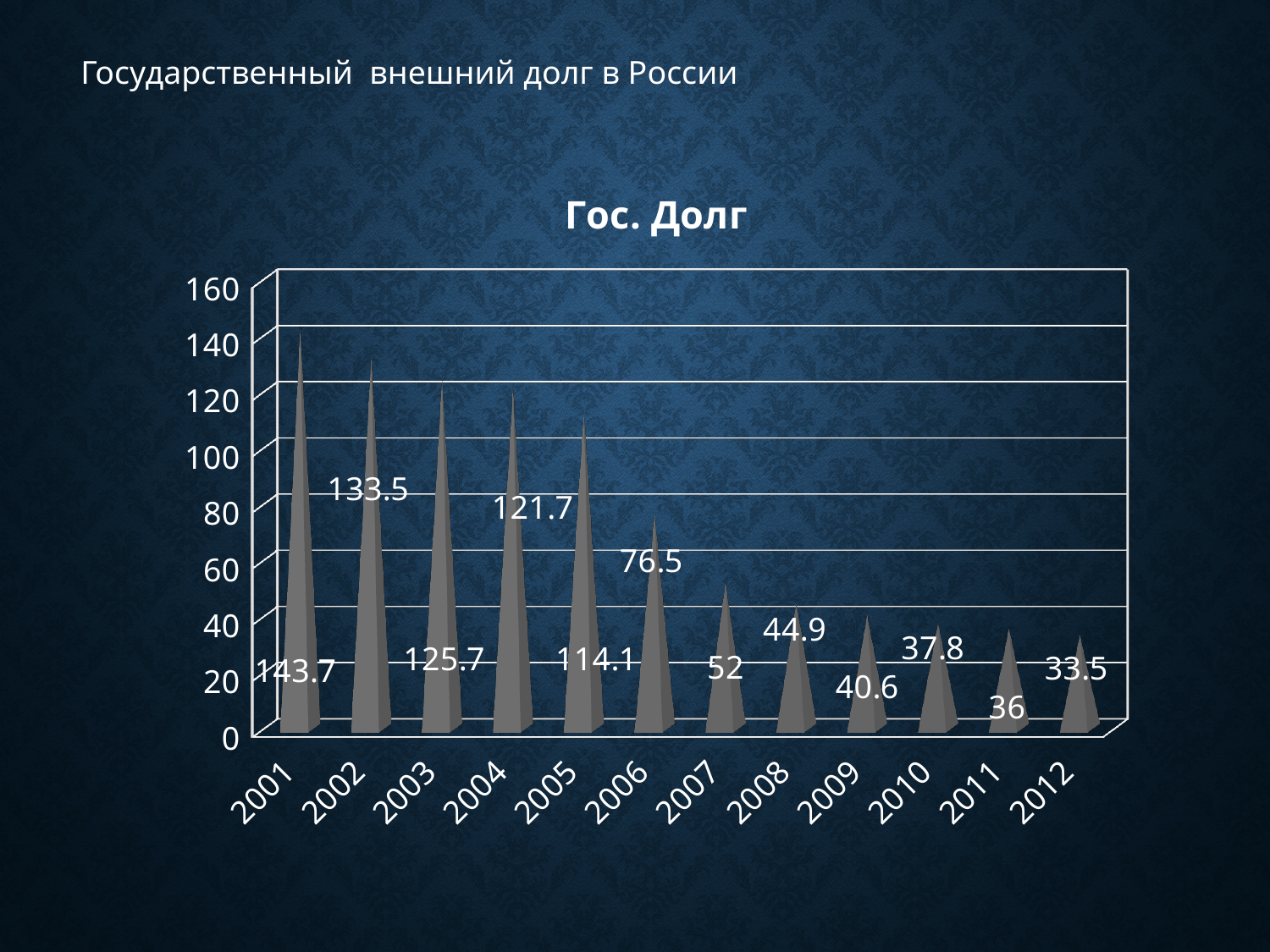
What is the value for 2006 in the Гос. Долг chart? 76.5 What is the value for 2001 in the Гос. Долг chart? 143.7 Which year has the highest value in the Гос. Долг chart? 2001 Which is larger in the Гос. Долг chart, the value for 2007 or the value for 2008? 2007 What kind of chart is the Гос. Долг chart? bar chart Do the values in the Гос. Долг chart rise or fall from 2001 to 2012? fall What is the difference between the values for 2001 and 2002 in the Гос. Долг chart? 10.2 Which year has the lowest value in the Гос. Долг chart? 2012 Is the value for 2004 in the Гос. Долг chart greater or less than 100? greater What is the value for 2012 in the Гос. Долг chart? 33.5 What is the difference between the values for 2005 and 2006 in the Гос. Долг chart? 37.6 How many years are shown on the x axis of the Гос. Долг chart? 12